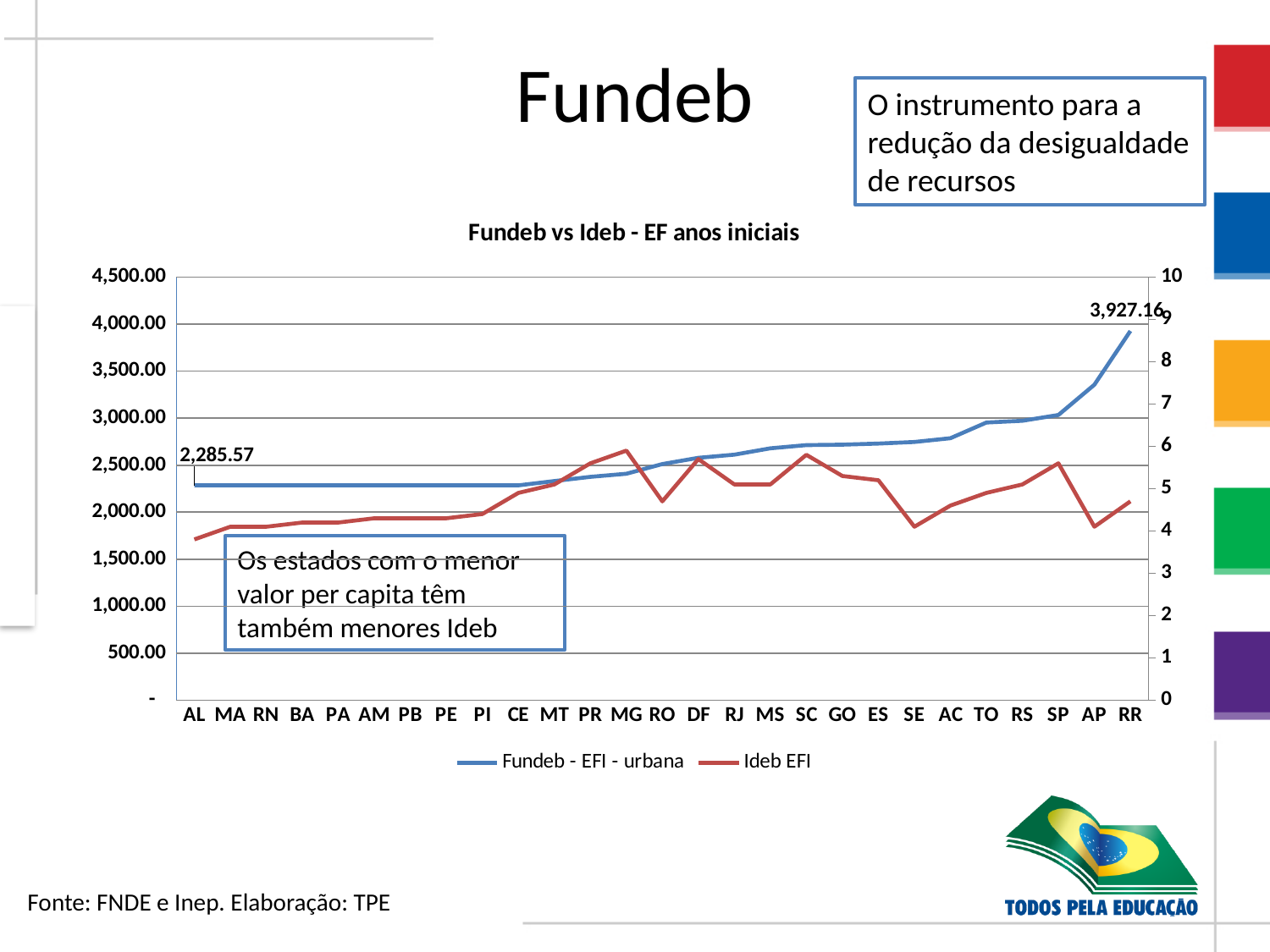
Which state has the highest Fundeb - EFI - urbana value? RR Does the Fundeb - EFI - urbana line rise or fall from AL to RR? rises How many states are shown on the x axis? 27 What type of chart is shown on the slide? line chart Is the Fundeb - EFI - urbana value for AP greater or less than 3,000.00? greater Is the Ideb EFI value for SE greater or less than 5? less What is the difference between the Fundeb - EFI - urbana values for RR and AL? 1,641.59 What is the Fundeb - EFI - urbana value for RR? 3,927.16 What is the Fundeb - EFI - urbana value for AL? 2,285.57 What is the title of the chart? Fundeb vs Ideb - EF anos iniciais Which state has the higher Ideb EFI value, MG or RO? MG How many series does the legend list? 2